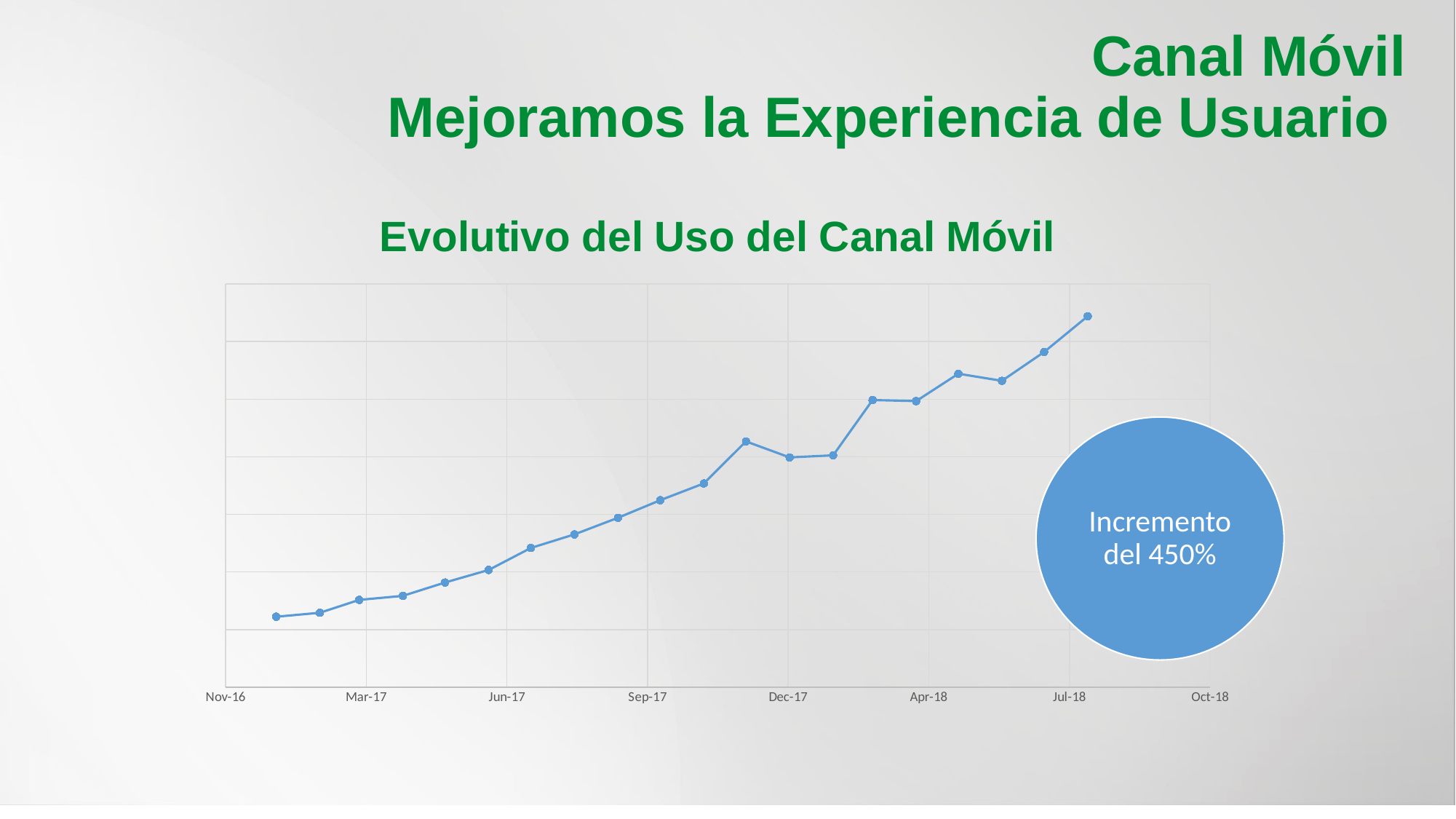
Which is larger, the value plotted at Sep-17 or the value plotted at Dec-17? Dec-17 What is the last date label on the x axis? Oct-18 What kind of chart is shown on the slide? line chart What is the title of the chart? Evolutivo del Uso del Canal Móvil How many data points are plotted on the line? 20 How many date labels are shown on the x axis? 8 What percentage increase is stated in the blue circle next to the chart? 450% What is the first date label on the x axis? Nov-16 Is the highest point of the line at the left end or the right end of the series? right end Overall, do the values rise or fall from left to right along the x axis? rise Is the lowest point of the line at the left end or the right end of the series? left end Which is larger, the value plotted at Mar-17 or the value plotted at Dec-17? Dec-17